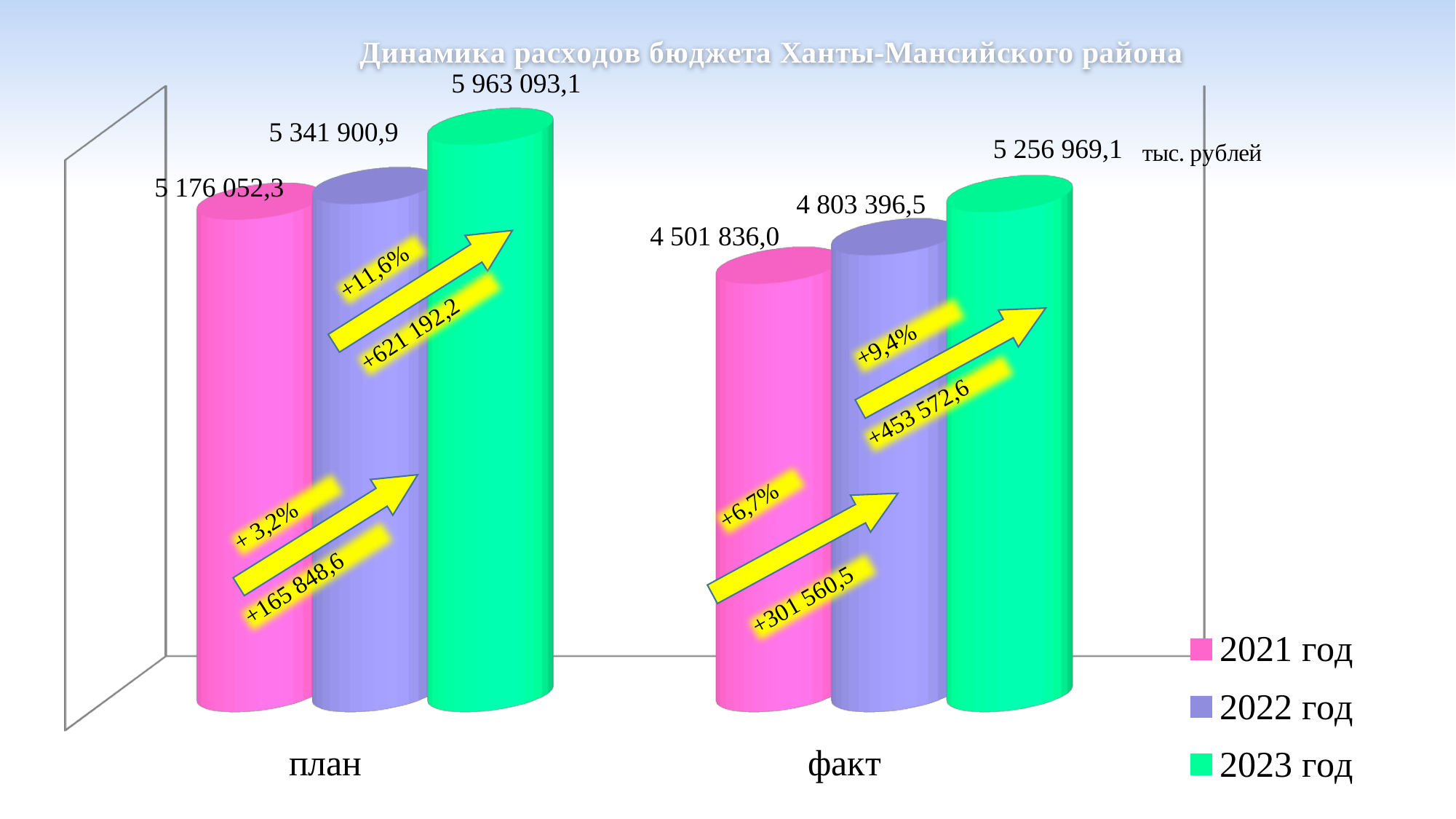
What is the value for 2021 год in the план category? 5 176 052,3 What is the value for 2022 год in the факт category? 4 803 396,5 What kind of chart is shown on the slide? bar chart What is the difference between the 2022 год and 2021 год values in the факт category? 301 560,5 How many categories are shown on the x axis? 2 What is the difference between the 2023 год and 2022 год values in the план category? 621 192,2 Which year has the highest value in the план category? 2023 год Which is larger: the 2023 год value for план or the 2023 год value for факт? план What is the value for 2023 год in the факт category? 5 256 969,1 Which year has the lowest value in the факт category? 2021 год How many series does the legend list? 3 What is the title of the chart? Динамика расходов бюджета Ханты-Мансийского района